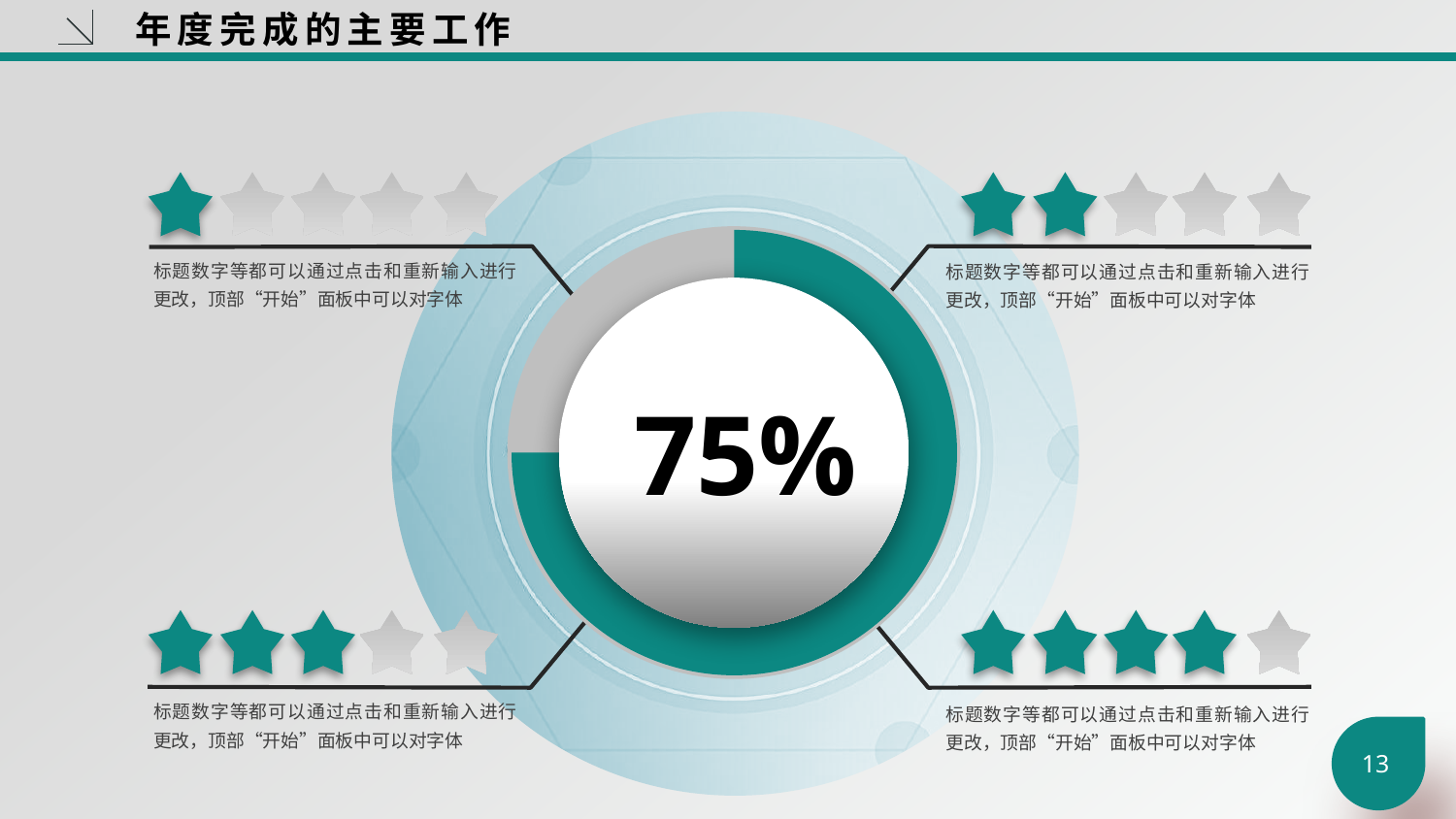
What percentage is printed in the centre of the donut chart? 75% Is the value shown in the donut chart greater or less than 50%? greater Which segment of the donut chart is larger, the teal one or the grey one? The teal one What share of the donut chart does the grey segment represent? 25% What is the title of the slide containing the donut chart? 年度完成的主要工作 What colour is the filled (completed) portion of the donut chart? Teal How many segments does the donut chart have? 2 What kind of chart is shown in the centre of the slide? Donut (pie) chart What share of the donut chart does the teal segment represent? 75%